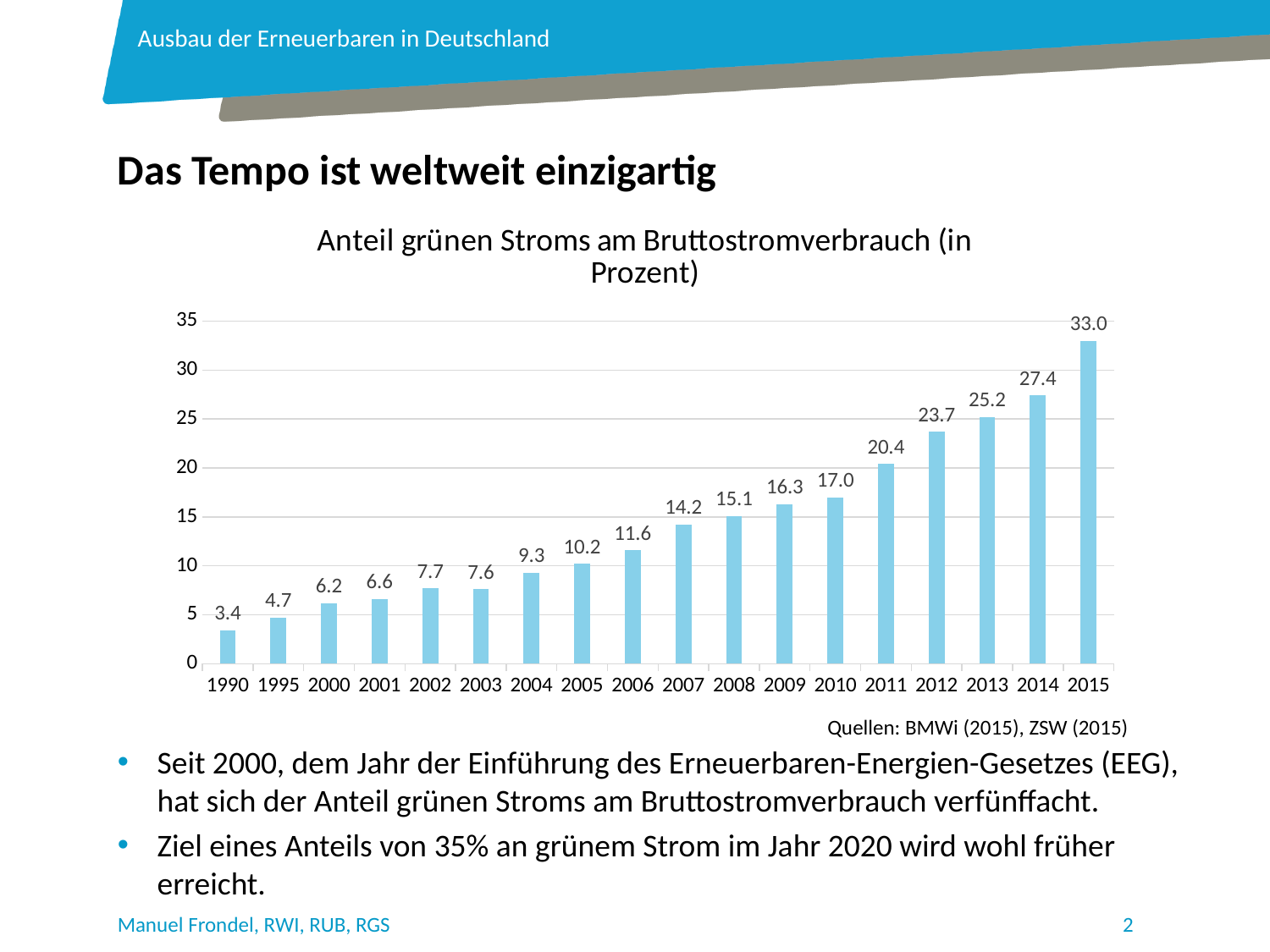
What kind of chart is this? bar chart What is the difference between the values for 2015 and 2000? 26.8 What is the value for 2015? 33.0 What is the title of the chart? Anteil grünen Stroms am Bruttostromverbrauch (in Prozent) Do the values generally rise or fall from 1990 to 2015? rise Which is larger, the value for 2002 or the value for 2003? 2002 Which year has the highest value? 2015 What is the value for 1990? 3.4 Which year has the lowest value? 1990 Is the value for 2011 greater or less than 20? greater What is the value for 2008? 15.1 How many years are shown on the x axis? 18